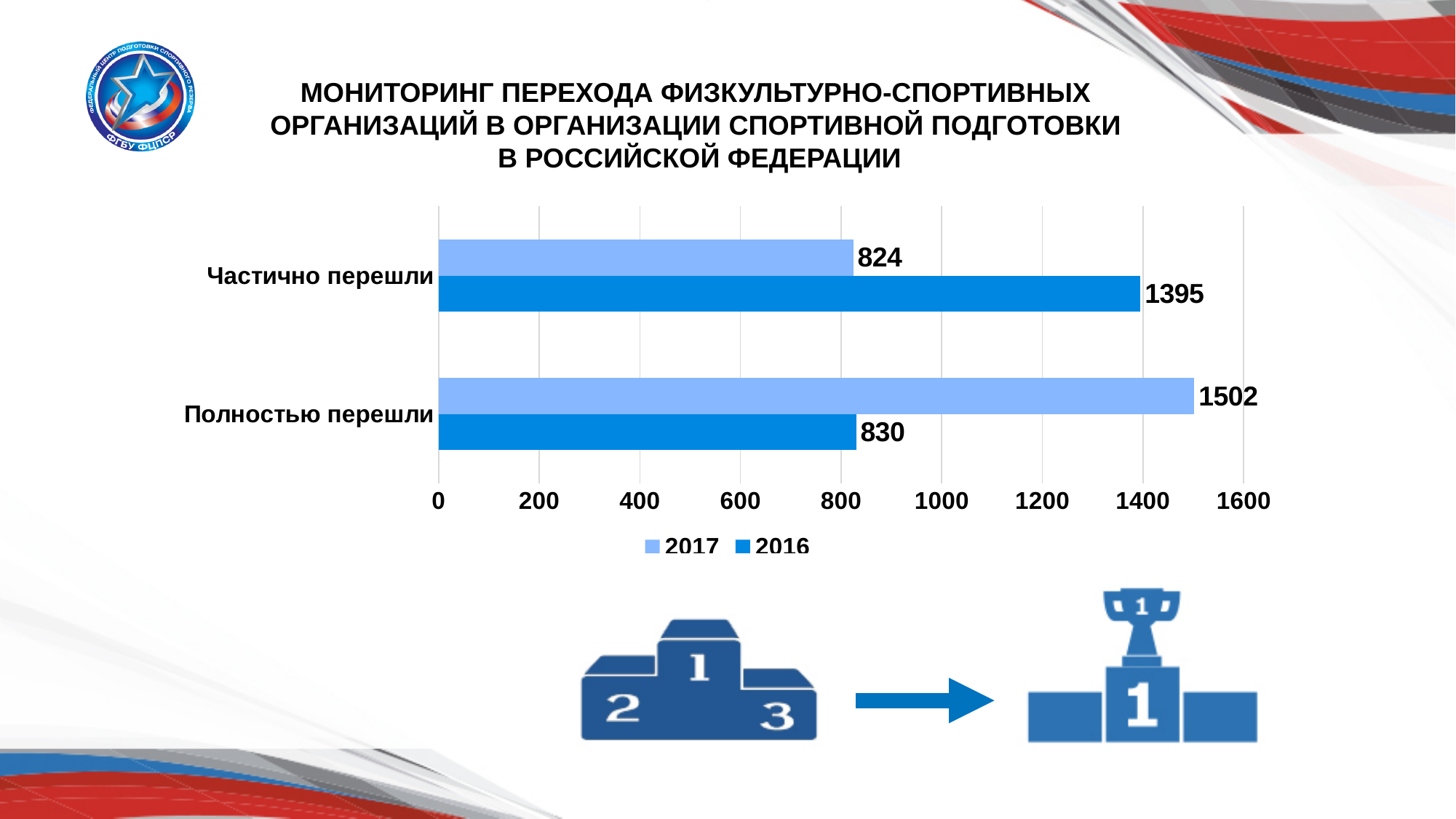
How many categories are shown on the chart? 2 What is the 2016 value for "Полностью перешли"? 830 What is the 2016 value for "Частично перешли"? 1395 What is the 2017 value for "Частично перешли"? 824 What kind of chart is shown on the slide? bar chart What is the difference between the 2016 and 2017 values for "Частично перешли"? 571 What is the difference between the 2017 and 2016 values for "Полностью перешли"? 672 Which category has the highest 2017 value? Полностью перешли What is the 2017 value for "Полностью перешли"? 1502 How many series does the legend list? 2 Which is larger: the 2016 value for "Частично перешли" or the 2017 value for "Частично перешли"? 2016 Which category has the lowest 2016 value? Полностью перешли